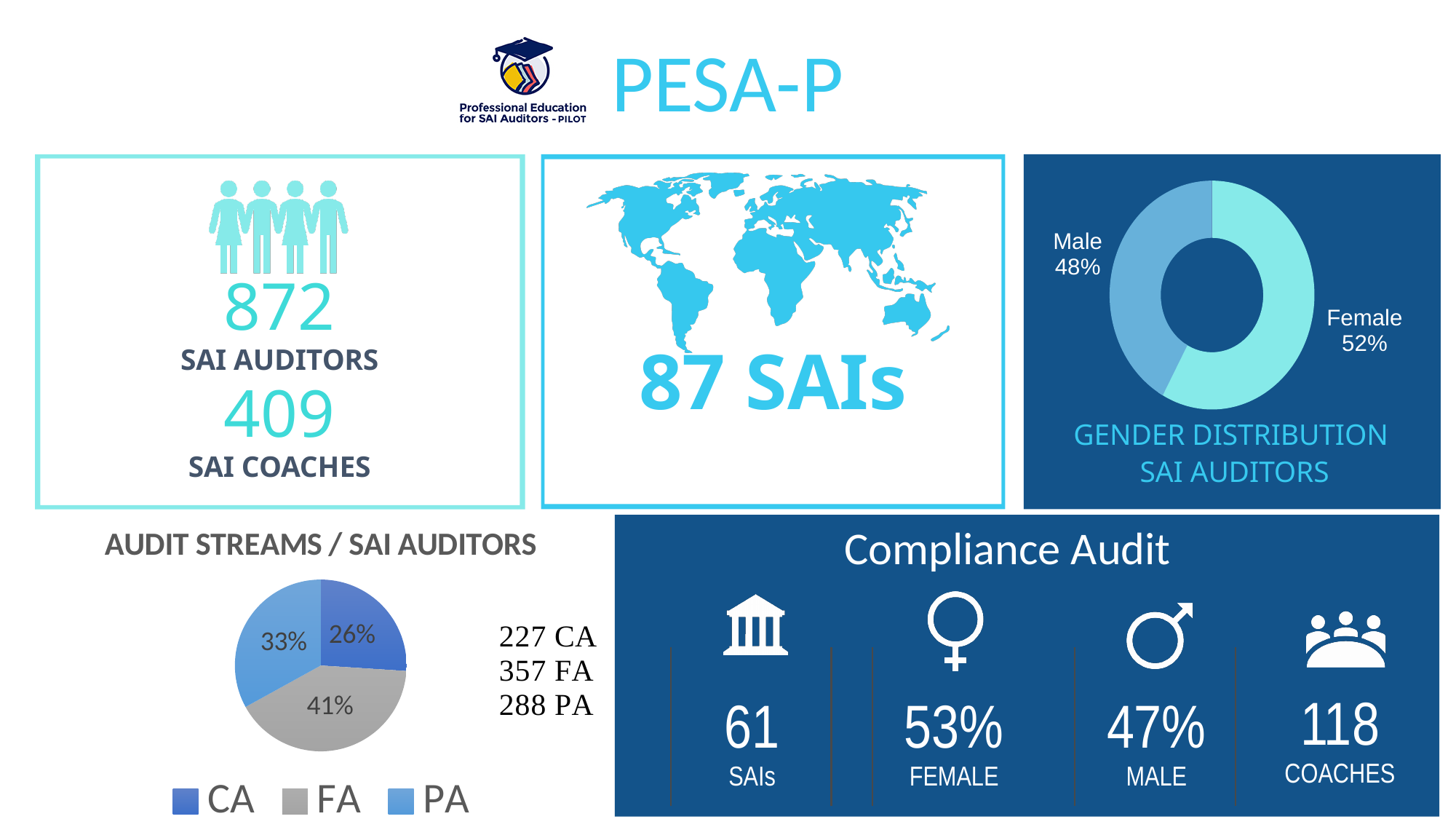
In the Audit Streams / SAI Auditors pie chart, what share is FA? 41% What kind of chart is the Gender Distribution SAI Auditors chart? Donut chart What are the legend entries of the Audit Streams / SAI Auditors pie chart? CA, FA, PA In the Gender Distribution SAI Auditors chart, what is the difference in percentage points between Female and Male? 4 In the Gender Distribution SAI Auditors chart, what share is Male? 48% In the Audit Streams / SAI Auditors pie chart, what share is PA? 33% In the Gender Distribution SAI Auditors chart, which gender has the larger share? Female In the Audit Streams / SAI Auditors pie chart, what share is CA? 26% In the Gender Distribution SAI Auditors chart, what share is Female? 52% In the Audit Streams / SAI Auditors pie chart, which audit stream has the largest share? FA In the Audit Streams / SAI Auditors pie chart, which audit stream has the smallest share? CA How many slices does the Audit Streams / SAI Auditors pie chart have? 3